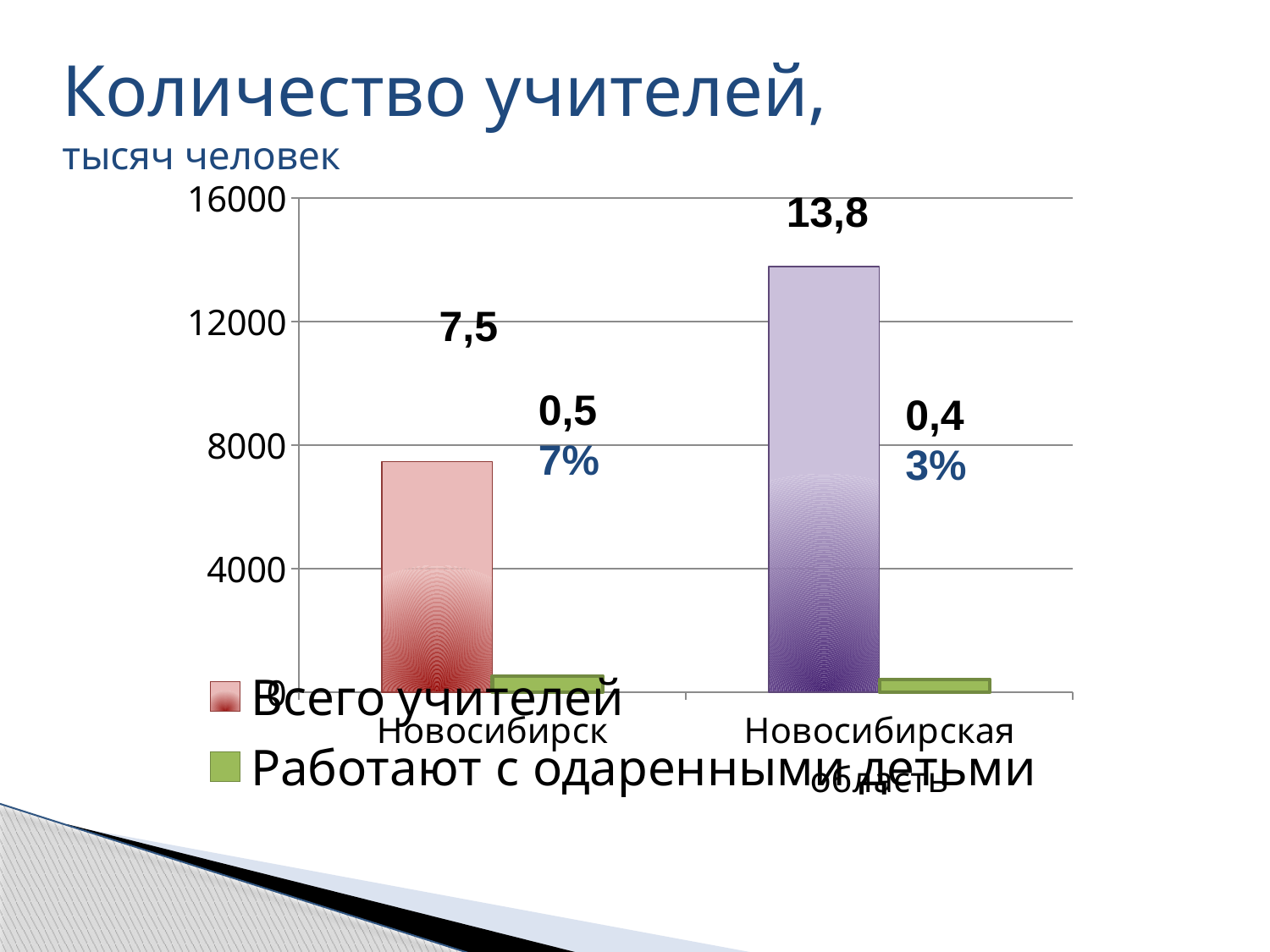
What is the value for 'Работают с одаренными детьми' in Новосибирск? 0,5 Which is larger for 'Работают с одаренными детьми': Новосибирск or Новосибирская область? Новосибирск What is the value for 'Работают с одаренными детьми' in Новосибирская область? 0,4 How many categories are shown on the x axis? 2 How many series does the legend list? 2 Is the 'Всего учителей' bar for Новосибирская область greater or less than 12000 on the axis? greater What is the value for 'Всего учителей' in Новосибирск? 7,5 What is the difference between the 'Всего учителей' values for Новосибирская область and Новосибирск? 6,3 What percentage is shown next to the Новосибирск bars? 7% Which category has the higher value for 'Всего учителей'? Новосибирская область Is the 'Всего учителей' bar for Новосибирск greater or less than 8000 on the axis? less What is the value for 'Всего учителей' in Новосибирская область? 13,8